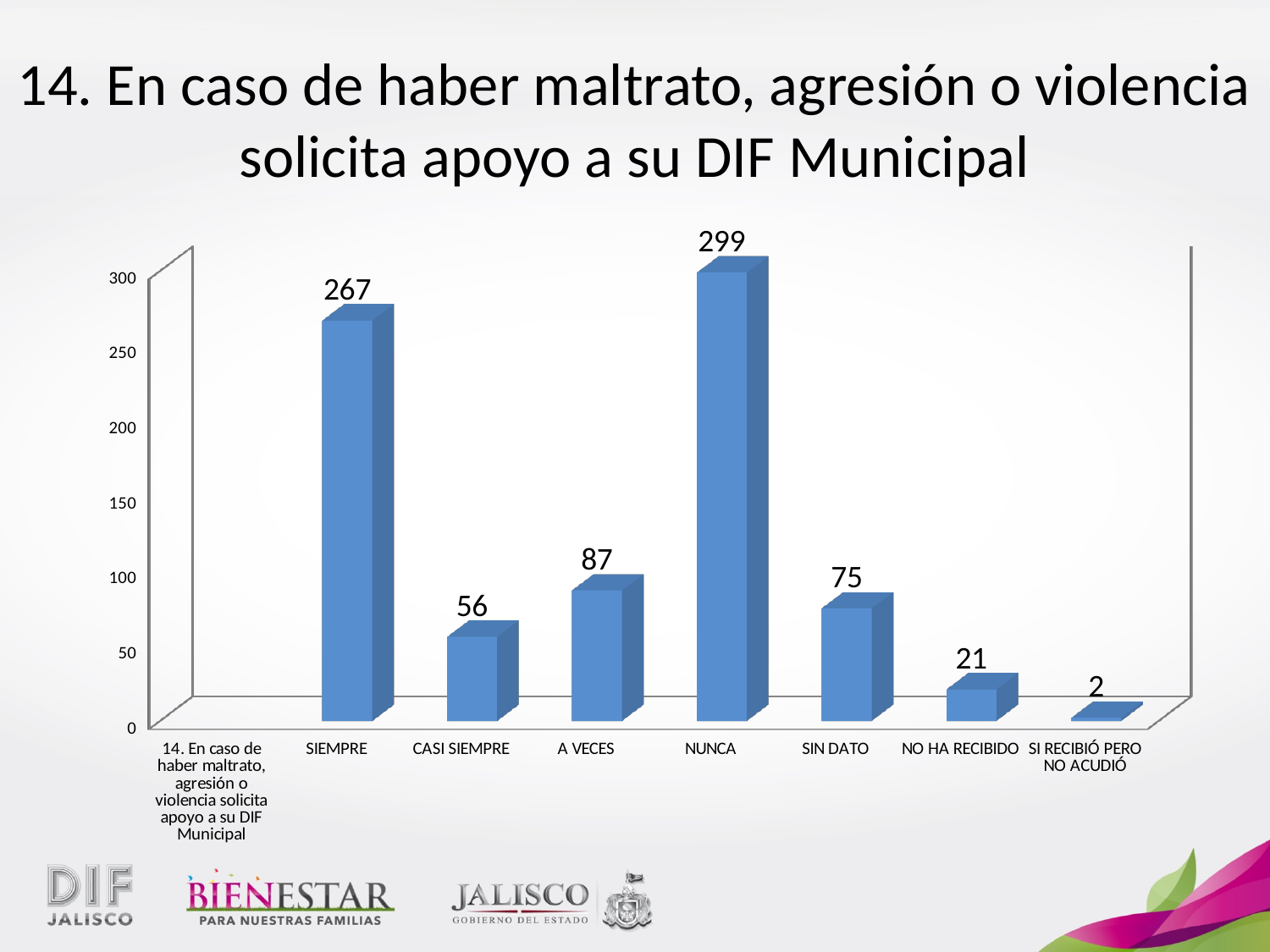
How many bars are plotted in the chart? 7 What is the value for SIEMPRE? 267 What is the difference between the values for A VECES and SIN DATO? 12 What is the difference between the values for NUNCA and SIEMPRE? 32 Which category has the lowest value? SI RECIBIÓ PERO NO ACUDIÓ What kind of chart is shown on the slide? bar chart What is the value for CASI SIEMPRE? 56 Which category has the highest value? NUNCA Which is larger, the value for A VECES or the value for CASI SIEMPRE? A VECES What is the value for NUNCA? 299 Is the value for NO HA RECIBIDO greater or less than 50? less What is the value for SI RECIBIÓ PERO NO ACUDIÓ? 2